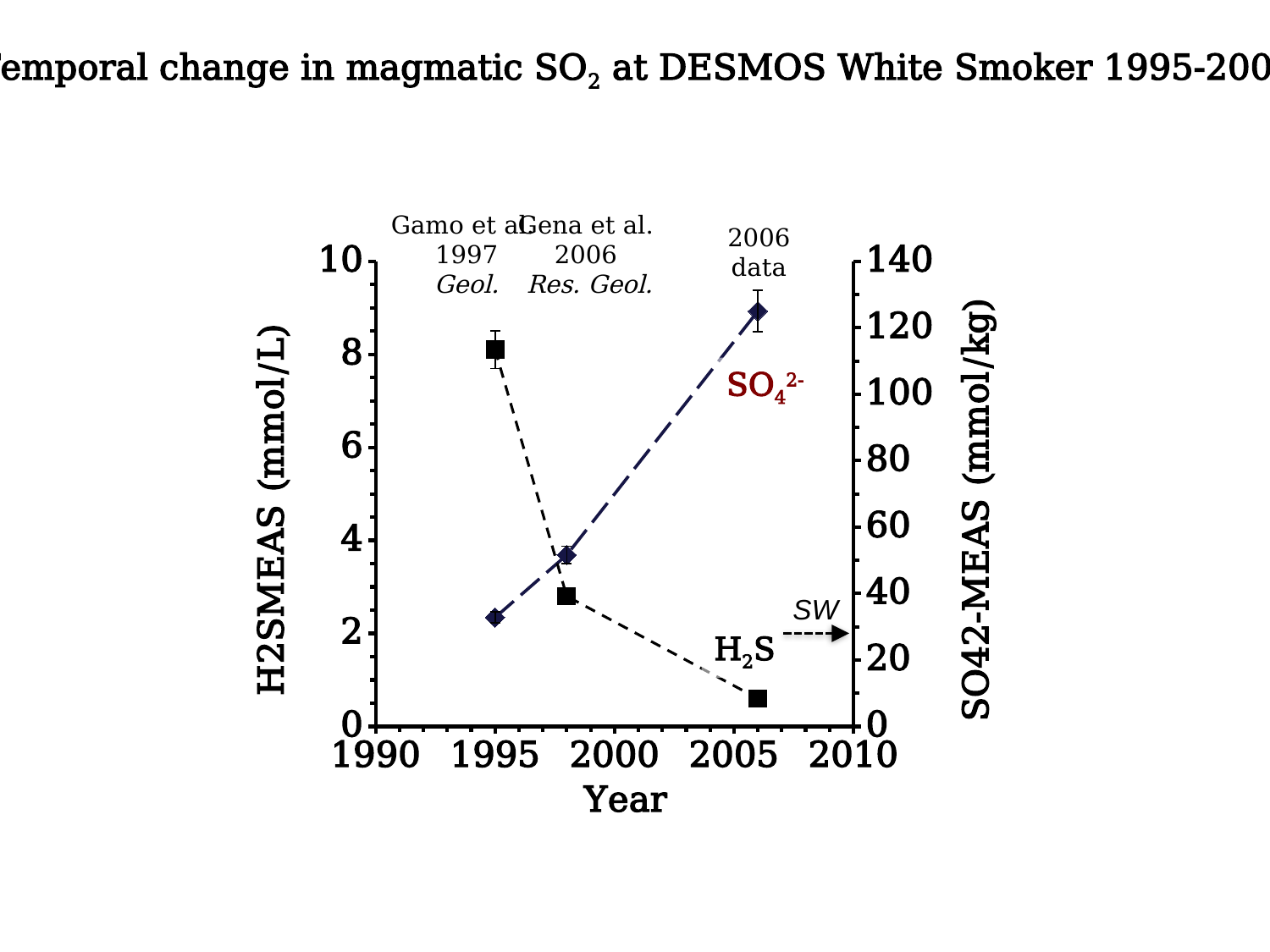
In which year is the SO4 2- value lowest? 1995 Is the H2S value for 1995 greater or less than 6 mmol/L? greater Which year has the larger H2S value, 1995 or 1998? 1995 Is the SO4 2- value for 2006 greater or less than 100 mmol/kg? greater Does the SO4 2- series rise or fall from 1995 to 2006? rise What is the title of the x axis? Year How many data points does the H2S series have? 3 What kind of chart is shown on the slide? line chart Is the H2S value for 2006 greater or less than 2 mmol/L? less In which year is the H2S value highest? 1995 How many data series are plotted on the chart? 2 Does the H2S series rise or fall from 1995 to 2006? fall